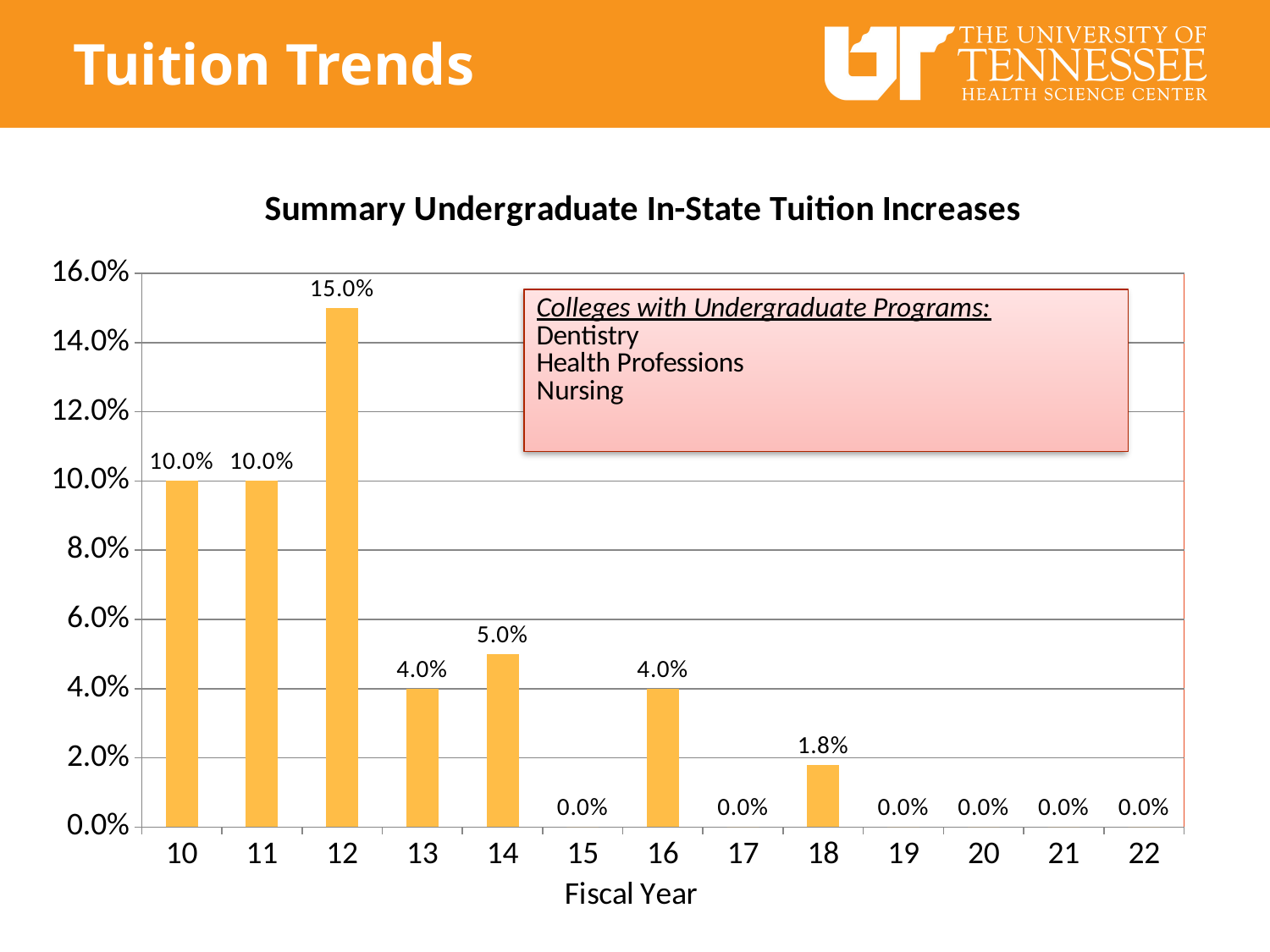
Do the tuition increases generally rise or fall from fiscal year 12 to fiscal year 22? Fall What is the title of the chart? Summary Undergraduate In-State Tuition Increases What is the difference between the tuition increase in fiscal year 12 and fiscal year 13? 11.0% How many fiscal years are shown on the x axis? 13 Is the value for fiscal year 12 greater or less than 14.0%? greater What kind of chart is shown on the slide? Bar chart What is the tuition increase for fiscal year 14? 5.0% What is the tuition increase for fiscal year 12? 15.0% What is the tuition increase for fiscal year 18? 1.8% How many fiscal years show a tuition increase of 0.0%? 6 Which fiscal year has the highest tuition increase? 12 Which is larger, the tuition increase in fiscal year 14 or fiscal year 16? Fiscal year 14